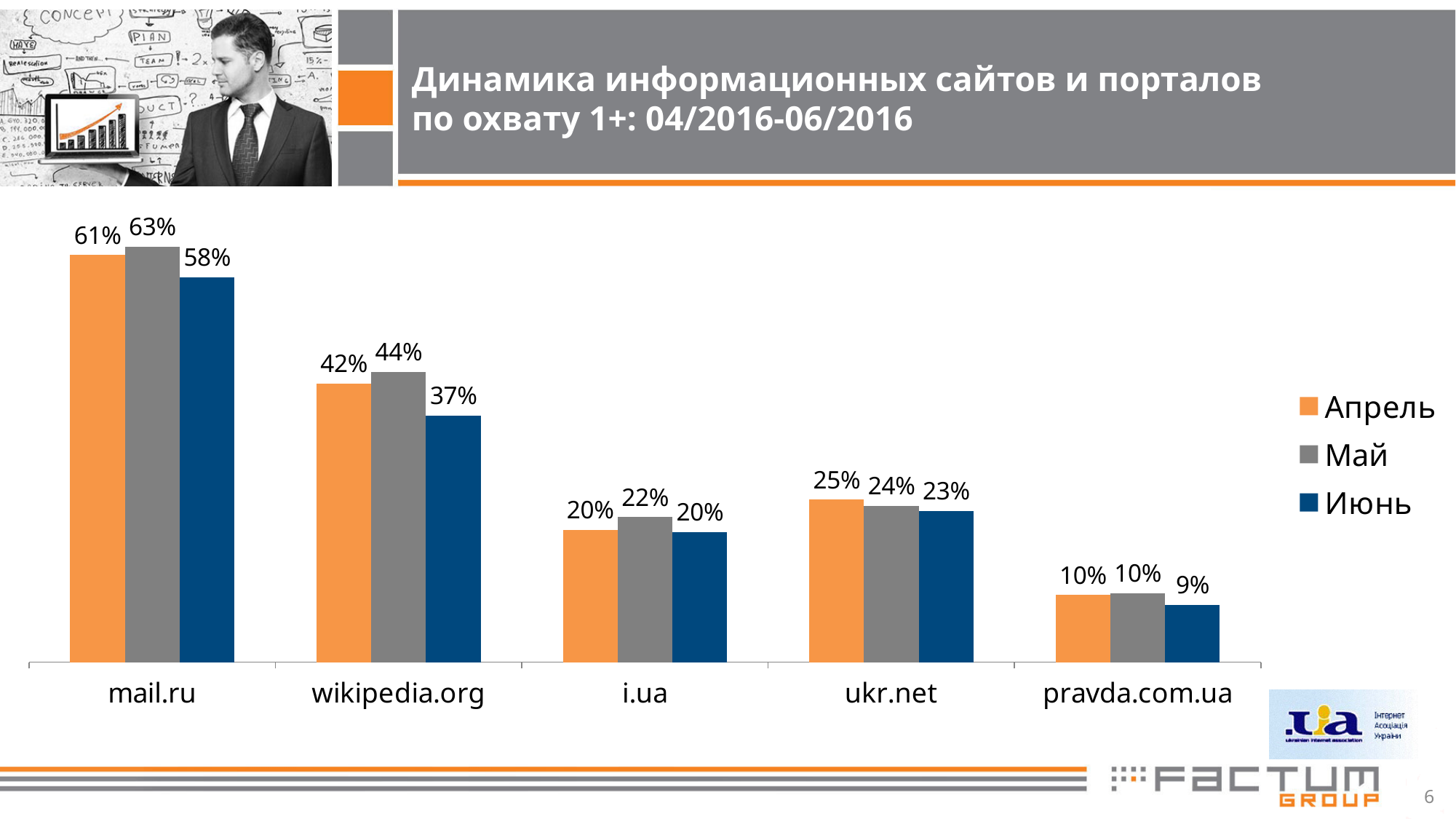
What is the value for pravda.com.ua in Июнь (June)? 9% How many series does the legend list? 3 What kind of chart is shown on the slide? Bar chart Which is larger for i.ua: the Апрель (April) value or the Май (May) value? Май (May) Which colour represents Июнь (June) in the legend? Dark blue What is the value for mail.ru in Май (May)? 63% What is the difference between the Май (May) and Июнь (June) values for wikipedia.org? 7% How many sites are shown on the x axis? 5 What is the value for ukr.net in Апрель (April)? 25% What is the value for wikipedia.org in Июнь (June)? 37% Which site has the lowest value in Май (May)? pravda.com.ua Which site has the highest value in Апрель (April)? mail.ru